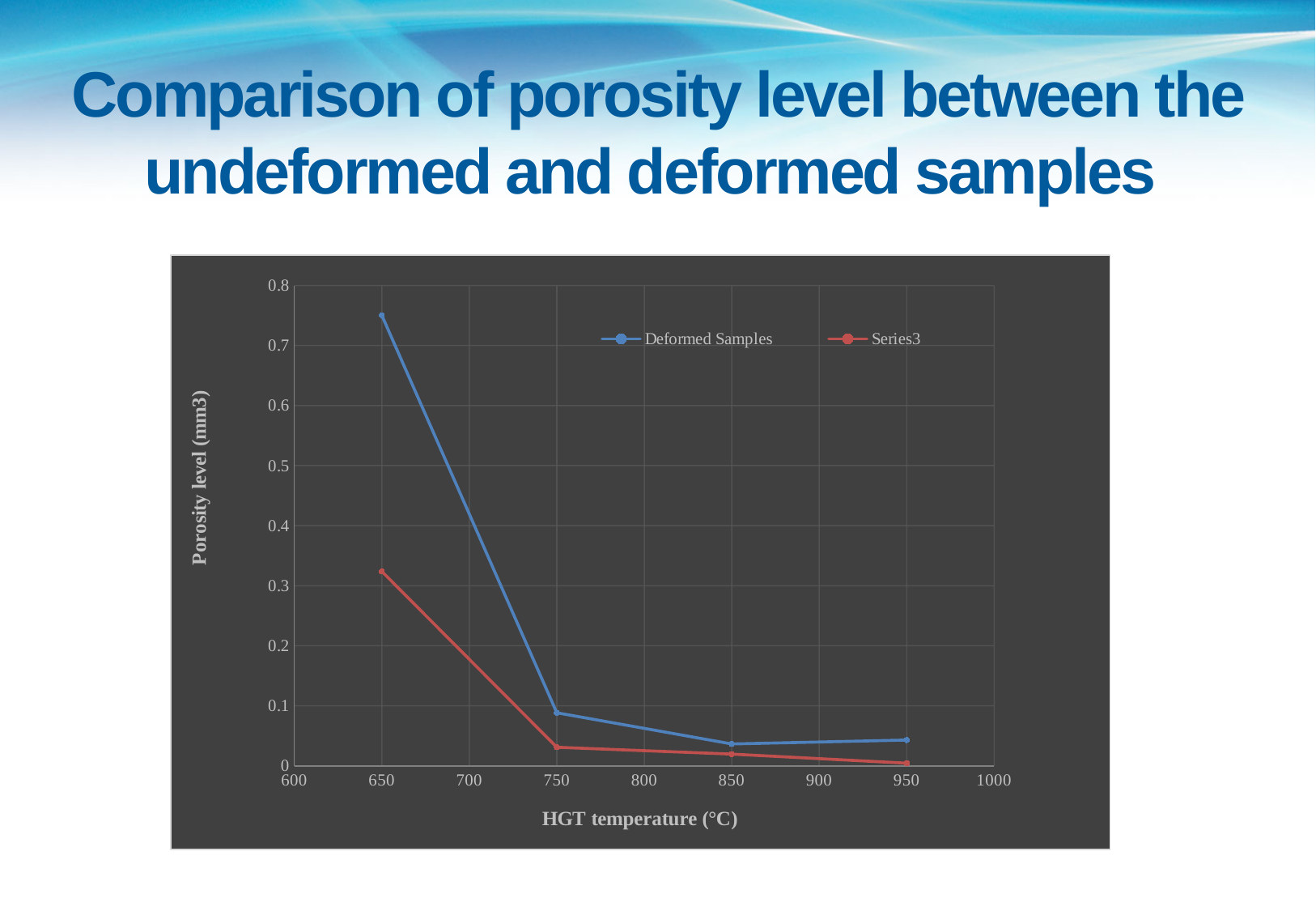
At which HGT temperature does the Deformed Samples series reach its highest porosity level? 650 What is the title of the y axis? Porosity level (mm3) Is the value for Deformed Samples at 650 °C greater or less than 0.7? greater Does the porosity level for Series3 rise or fall as HGT temperature increases from 650 to 950 °C? fall What is the title of the x axis? HGT temperature (°C) At 650 °C, which series has the higher porosity level, Deformed Samples or Series3? Deformed Samples Is the value for Deformed Samples at 750 °C greater or less than 0.2? less Is the value for Series3 at 650 °C greater or less than 0.4? less How many series does the legend list? 2 How many data points are plotted for the Deformed Samples series? 4 What kind of chart is shown on the slide? line chart